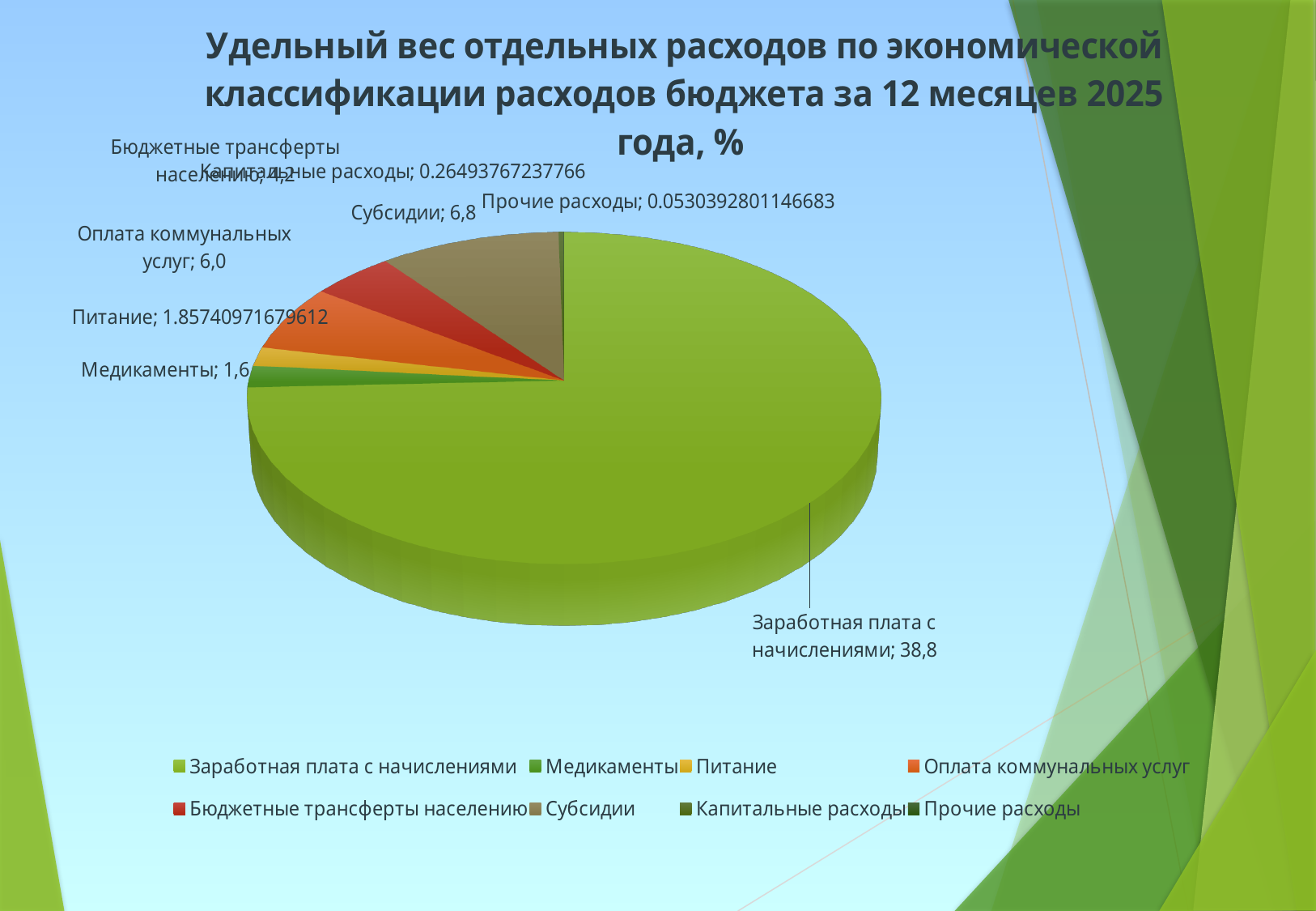
What is the value for Заработная плата с начислениями? 38,8 What kind of chart is shown on the slide? pie chart What is the value for Прочие расходы? 0.0530392801146683 What is the difference between the values for Субсидии and Оплата коммунальных услуг? 0,8 Which category has the smallest value? Прочие расходы Which is larger, Субсидии or Оплата коммунальных услуг? Субсидии What is the value for Оплата коммунальных услуг? 6,0 What is the value for Субсидии? 6,8 How many categories does the legend list? 8 What is the value for Капитальные расходы? 0.26493767237766 What is the value for Медикаменты? 1,6 Which category has the largest slice? Заработная плата с начислениями